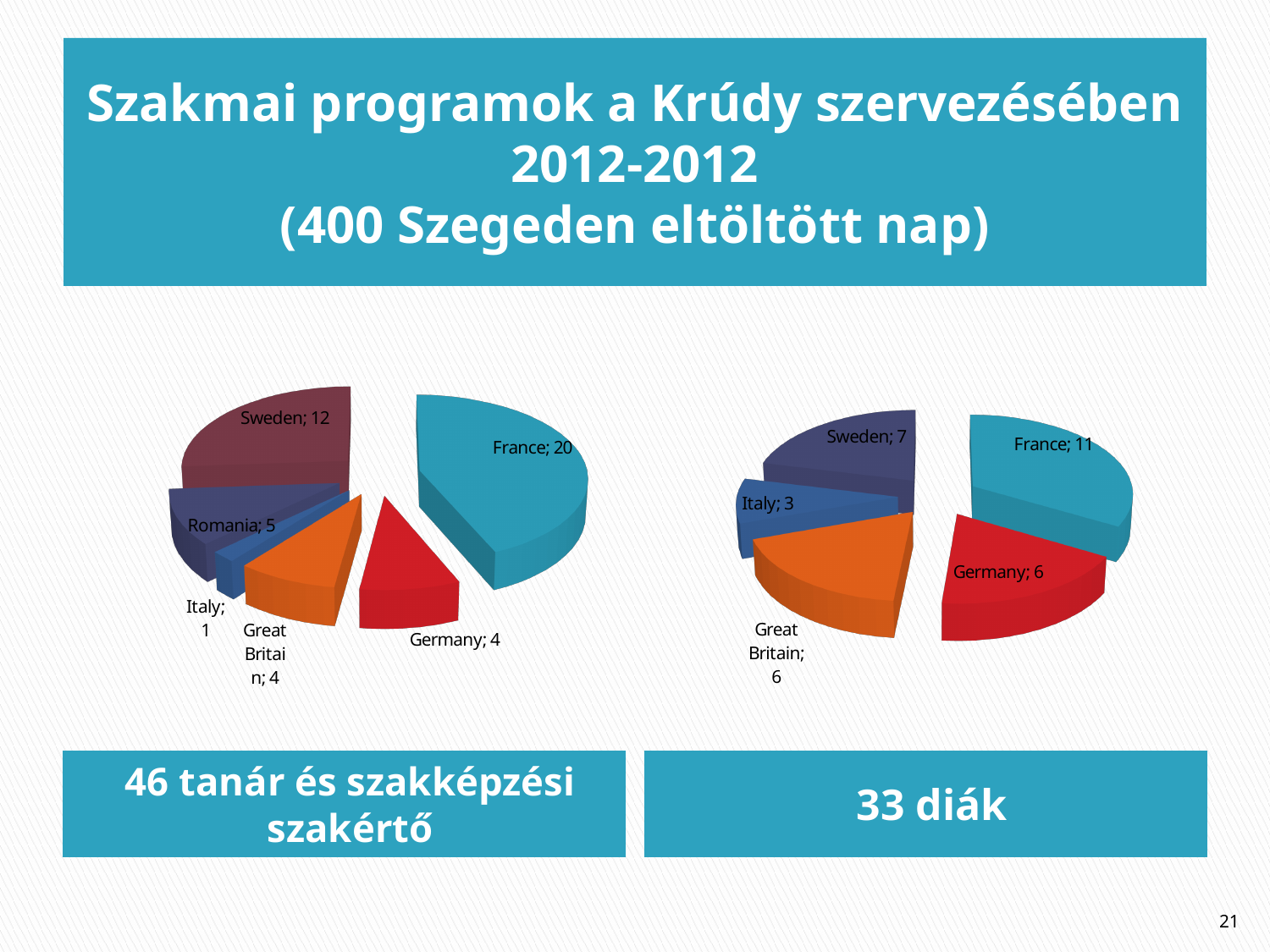
In the right pie chart, which country has the largest slice? France In the right pie chart, what is the value for Sweden? 7 How many slices does the right pie chart have? 5 In the left pie chart, which country has the smallest slice? Italy In the right pie chart, what share of the total does France represent? 33.3% What type of chart is shown on the left of the slide? Pie chart In the left pie chart, what is the difference between the values for France and Sweden? 8 In the right pie chart, which is larger, the value for Sweden or the value for Germany? Sweden How many slices does the left pie chart have? 6 In the left pie chart, what is the value for Romania? 5 In the right pie chart, what is the difference between the values for France and Italy? 8 In the left pie chart, what is the value for France? 20